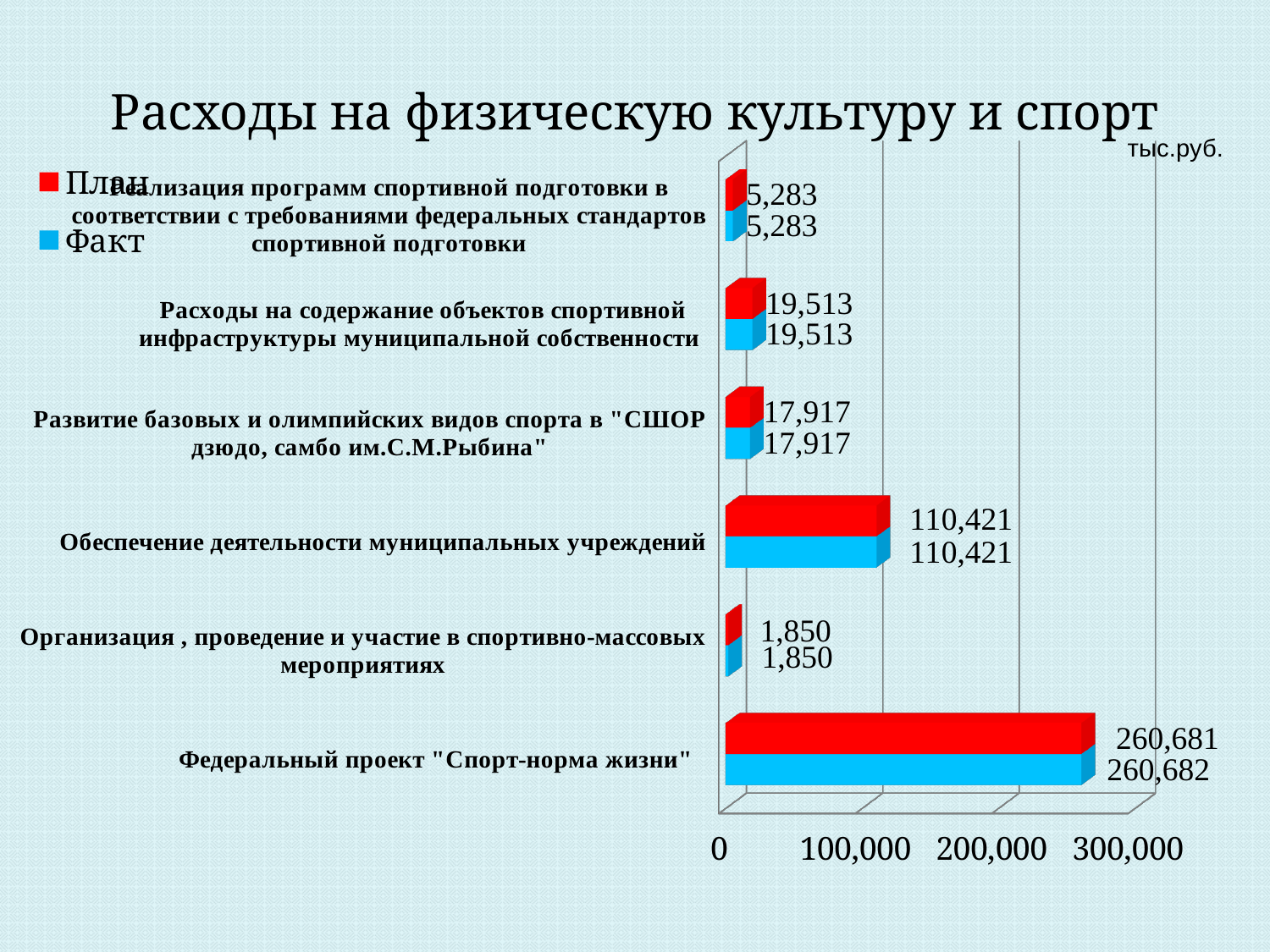
What is the Факт value for Обеспечение деятельности муниципальных учреждений? 110,421 Which category has the lowest План value? Организация, проведение и участие в спортивно-массовых мероприятиях What is the План value for Федеральный проект "Спорт-норма жизни"? 260,681 How many categories are shown in the chart? 6 How many series does the legend list? 2 What is the difference between the Факт and План values for Федеральный проект "Спорт-норма жизни"? 1 Which is larger: the План value for Расходы на содержание объектов спортивной инфраструктуры муниципальной собственности or the План value for Развитие базовых и олимпийских видов спорта в "СШОР дзюдо, самбо им.С.М.Рыбина"? Расходы на содержание объектов спортивной инфраструктуры муниципальной собственности What unit is indicated for the values in the chart? тыс.руб. Which category has the highest Факт value? Федеральный проект "Спорт-норма жизни" What is the План value for Организация, проведение и участие в спортивно-массовых мероприятиях? 1,850 What type of chart is shown on the slide? bar chart What is the Факт value for Федеральный проект "Спорт-норма жизни"? 260,682